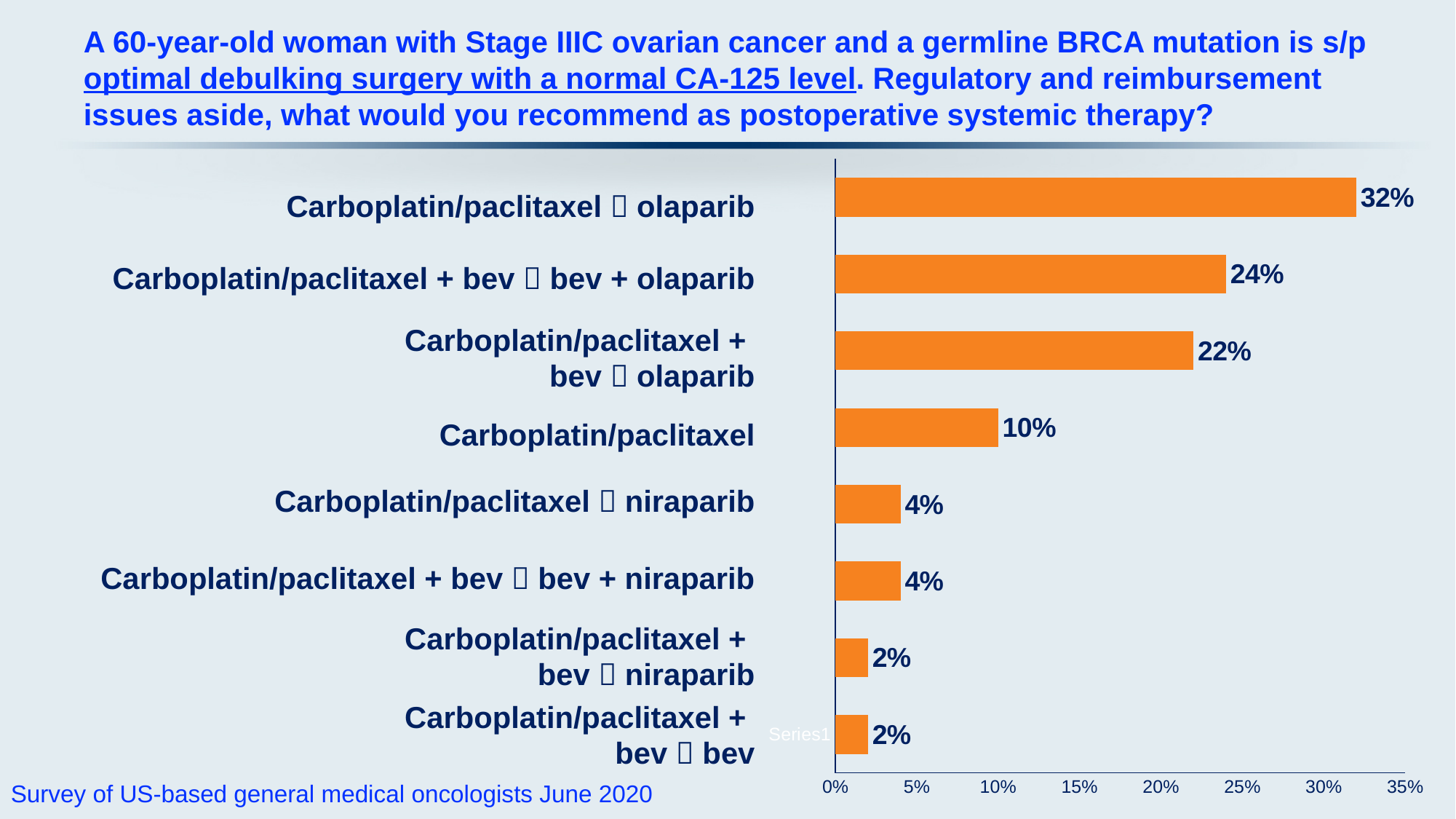
What percentage of respondents recommended Carboplatin/paclitaxel → niraparib? 4% What percentage of respondents recommended Carboplatin/paclitaxel + bev → bev? 2% What percentage of respondents recommended Carboplatin/paclitaxel alone? 10% Which treatment option received the highest percentage of recommendations? Carboplatin/paclitaxel → olaparib What type of chart is shown on the slide? Bar chart How many treatment options are shown in the chart? 8 What percentage of respondents recommended Carboplatin/paclitaxel + bev → bev + olaparib? 24% What percentage of respondents recommended Carboplatin/paclitaxel → olaparib? 32% What is the difference in percentage points between Carboplatin/paclitaxel + bev → olaparib and Carboplatin/paclitaxel alone? 12% Which received a higher percentage: Carboplatin/paclitaxel + bev → bev + olaparib or Carboplatin/paclitaxel + bev → olaparib? Carboplatin/paclitaxel + bev → bev + olaparib What is the maximum value shown on the horizontal axis of the chart? 35% What is the difference in percentage points between Carboplatin/paclitaxel → olaparib and Carboplatin/paclitaxel + bev → bev + olaparib? 8%